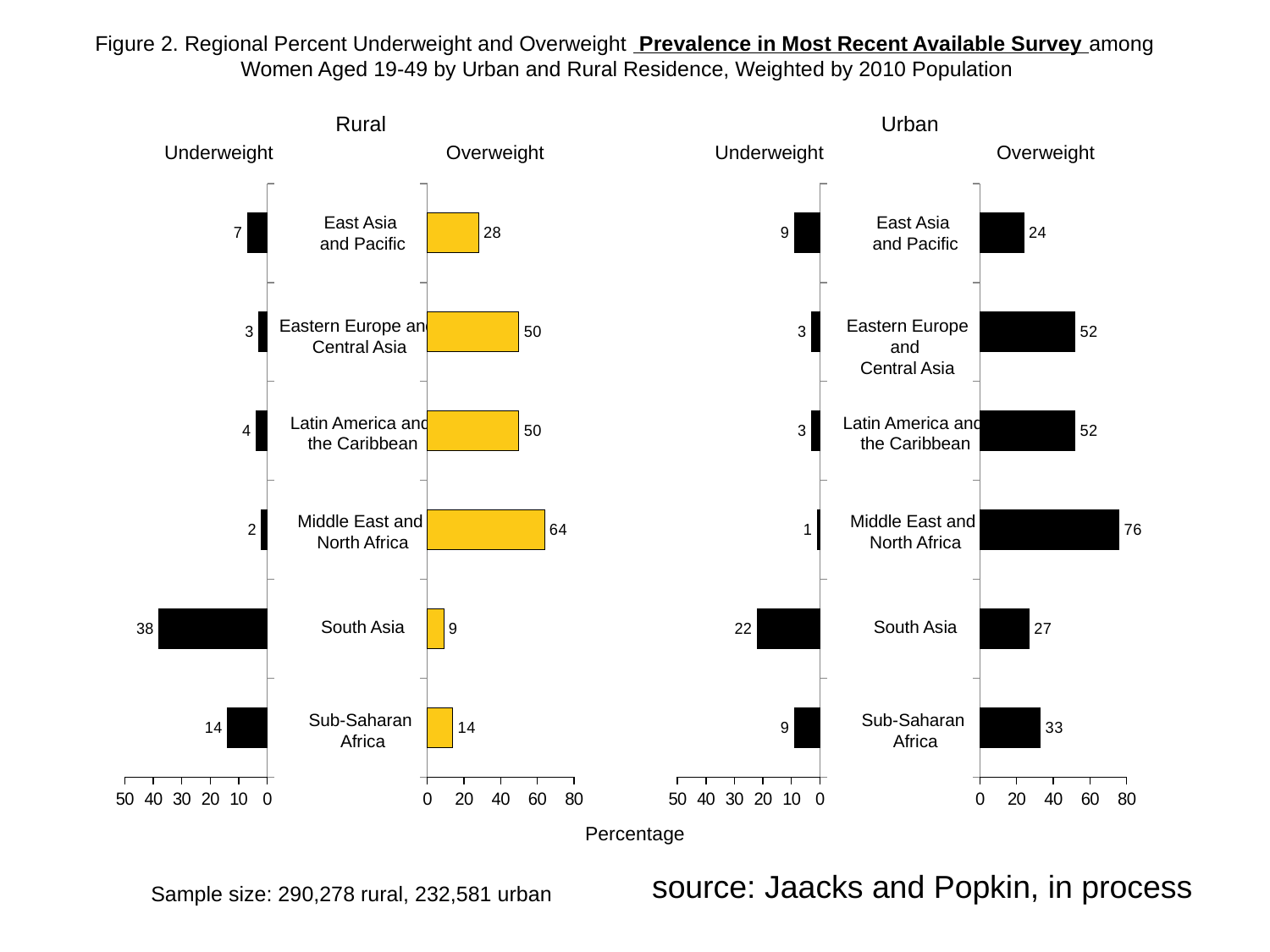
In the Urban Underweight chart, what is the difference between South Asia and East Asia and Pacific? 13 Which is larger: the Urban Overweight value for Sub-Saharan Africa or the Urban Overweight value for South Asia? Sub-Saharan Africa In the Rural Overweight chart, what is the value for Sub-Saharan Africa? 14 What colour are the bars in the Rural Overweight chart? yellow In the Urban Underweight chart, which region has the lowest value? Middle East and North Africa In the Rural Overweight chart, what is the difference between Middle East and North Africa and South Asia? 55 In the Rural Overweight chart, which region has the highest value? Middle East and North Africa In the Urban Overweight chart, what is the value for Middle East and North Africa? 76 What kind of chart is the Urban Overweight chart? bar chart How many regions are shown in the Rural Underweight chart? 6 In the Rural Underweight chart, what is the value for South Asia? 38 In the Urban Underweight chart, is the value for South Asia greater or less than 10? greater